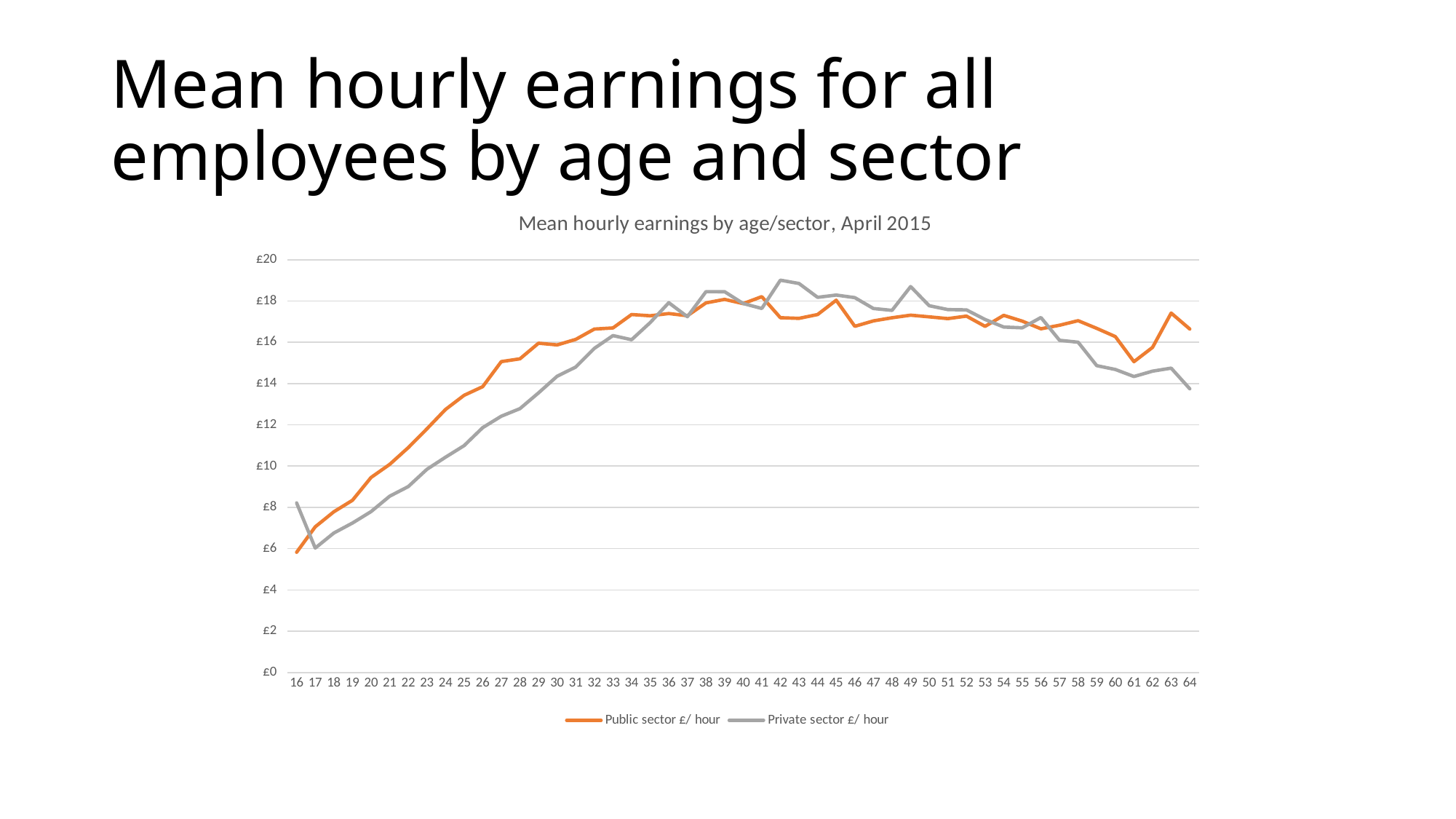
Is the Public sector £/ hour value at age 25 greater or less than £12? greater What kind of chart is shown on the slide? Line chart At age 42, which series has the higher value, Public sector £/ hour or Private sector £/ hour? Private sector £/ hour Is the Private sector £/ hour value at age 28 greater or less than £14? less How many age categories are plotted along the x axis? 49 At age 25, which series has the higher value, Public sector £/ hour or Private sector £/ hour? Public sector £/ hour At which age is the Private sector £/ hour value lowest? 17 Is the Private sector £/ hour value at age 42 greater or less than £18? greater How many series does the legend list? 2 Which series is drawn in orange? Public sector £/ hour What is the title of the chart? Mean hourly earnings by age/sector, April 2015